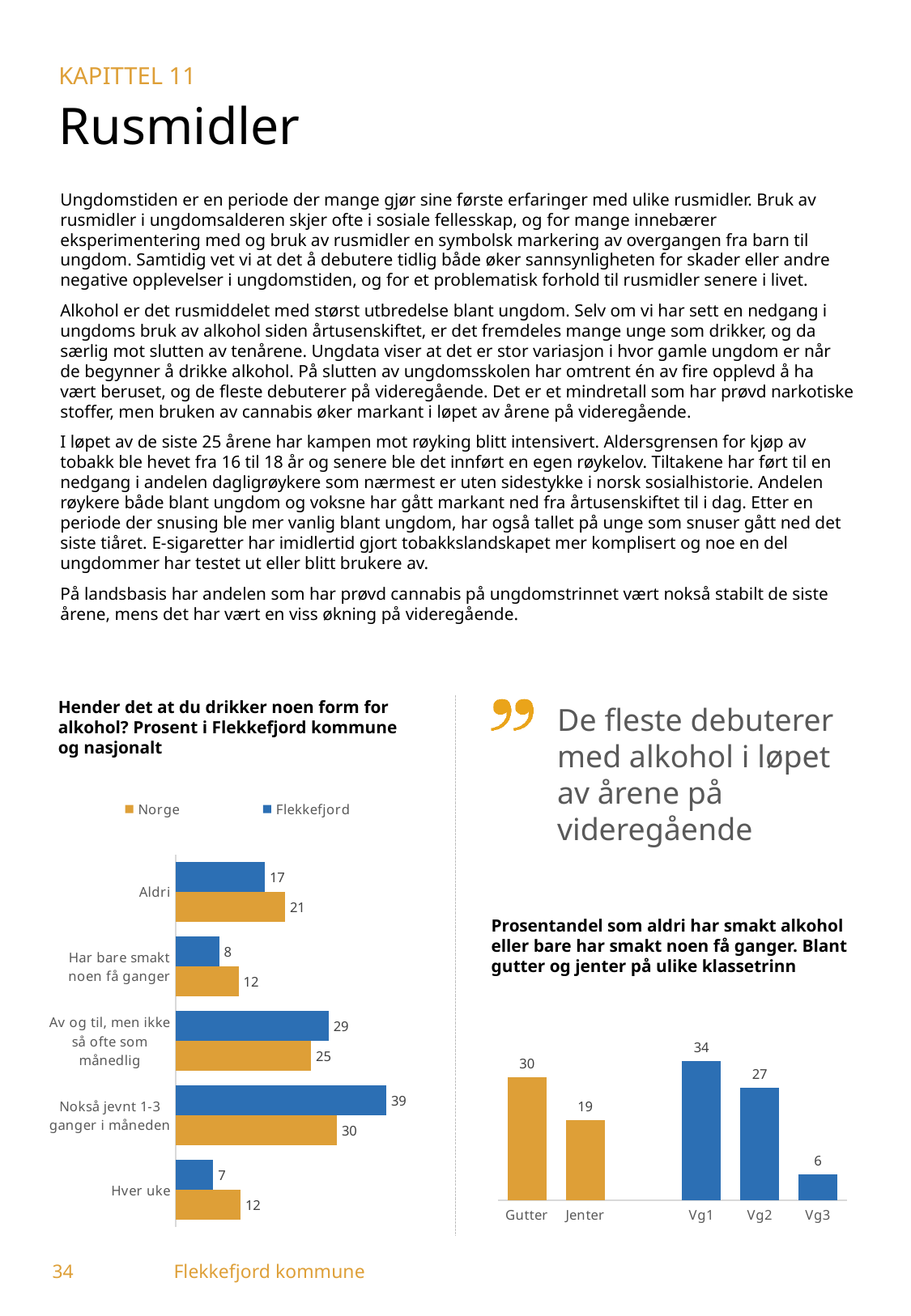
In the chart 'Hender det at du drikker noen form for alkohol?', what is the Flekkefjord value for 'Nokså jevnt 1-3 ganger i måneden'? 39 In the chart 'Hender det at du drikker noen form for alkohol?', what is the Norge value for 'Aldri'? 21 In the chart 'Hender det at du drikker noen form for alkohol?', how many series does the legend list? 2 In the chart 'Prosentandel som aldri har smakt alkohol eller bare har smakt noen få ganger', which category has the highest value? Vg1 What kind of chart is 'Hender det at du drikker noen form for alkohol?'? Bar chart In the chart 'Hender det at du drikker noen form for alkohol?', which category has the lowest Flekkefjord value? Hver uke In the chart 'Hender det at du drikker noen form for alkohol?', what is the difference between the Flekkefjord and Norge values for 'Nokså jevnt 1-3 ganger i måneden'? 9 In the chart 'Hender det at du drikker noen form for alkohol?', is the Norge or the Flekkefjord value larger for 'Har bare smakt noen få ganger'? Norge In the chart 'Prosentandel som aldri har smakt alkohol eller bare har smakt noen få ganger', what is the value for Jenter? 19 In the chart 'Prosentandel som aldri har smakt alkohol eller bare har smakt noen få ganger', what is the difference between Gutter and Jenter? 11 In the chart 'Hender det at du drikker noen form for alkohol?', how many categories are shown? 5 In the chart 'Prosentandel som aldri har smakt alkohol eller bare har smakt noen få ganger', do the values rise or fall from Vg1 to Vg3? Fall